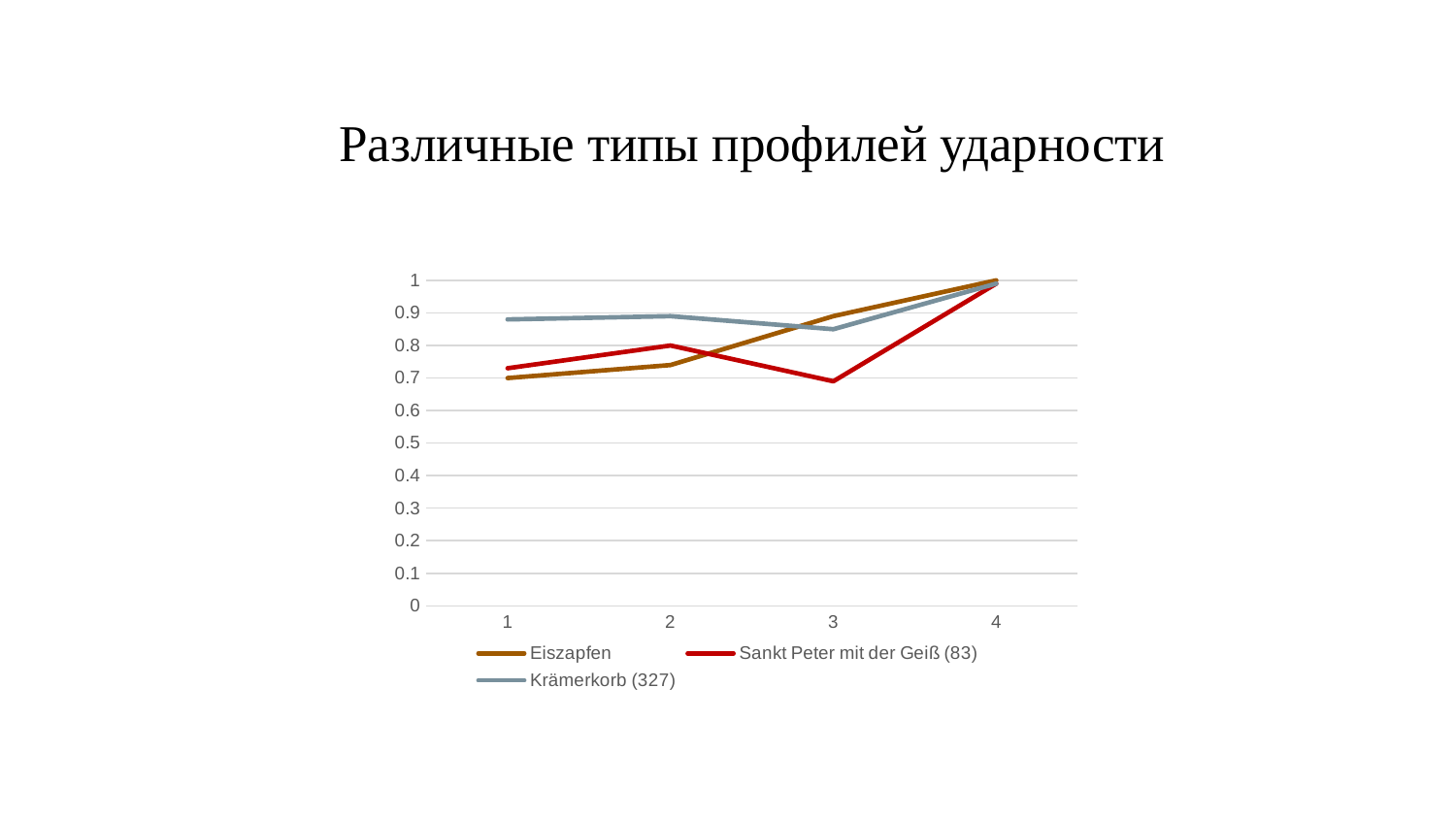
How many points are there along the x axis? 4 At point 3, which is larger: Eiszapfen or Sankt Peter mit der Geiß (83)? Eiszapfen How many series does the legend list? 3 Which series is drawn with the red line? Sankt Peter mit der Geiß (83) Which series has the lowest value at point 3? Sankt Peter mit der Geiß (83) What is the title of the slide above the chart? Различные типы профилей ударности Is the value for Krämerkorb (327) at point 1 greater or less than 0.8? greater Is the value for Eiszapfen at point 1 greater or less than 0.8? less Does the Eiszapfen line rise or fall from point 1 to point 4? rises At point 1, which is larger: Krämerkorb (327) or Eiszapfen? Krämerkorb (327) What kind of chart is shown on the slide? line chart Is the value for Sankt Peter mit der Geiß (83) at point 3 greater or less than 0.8? less